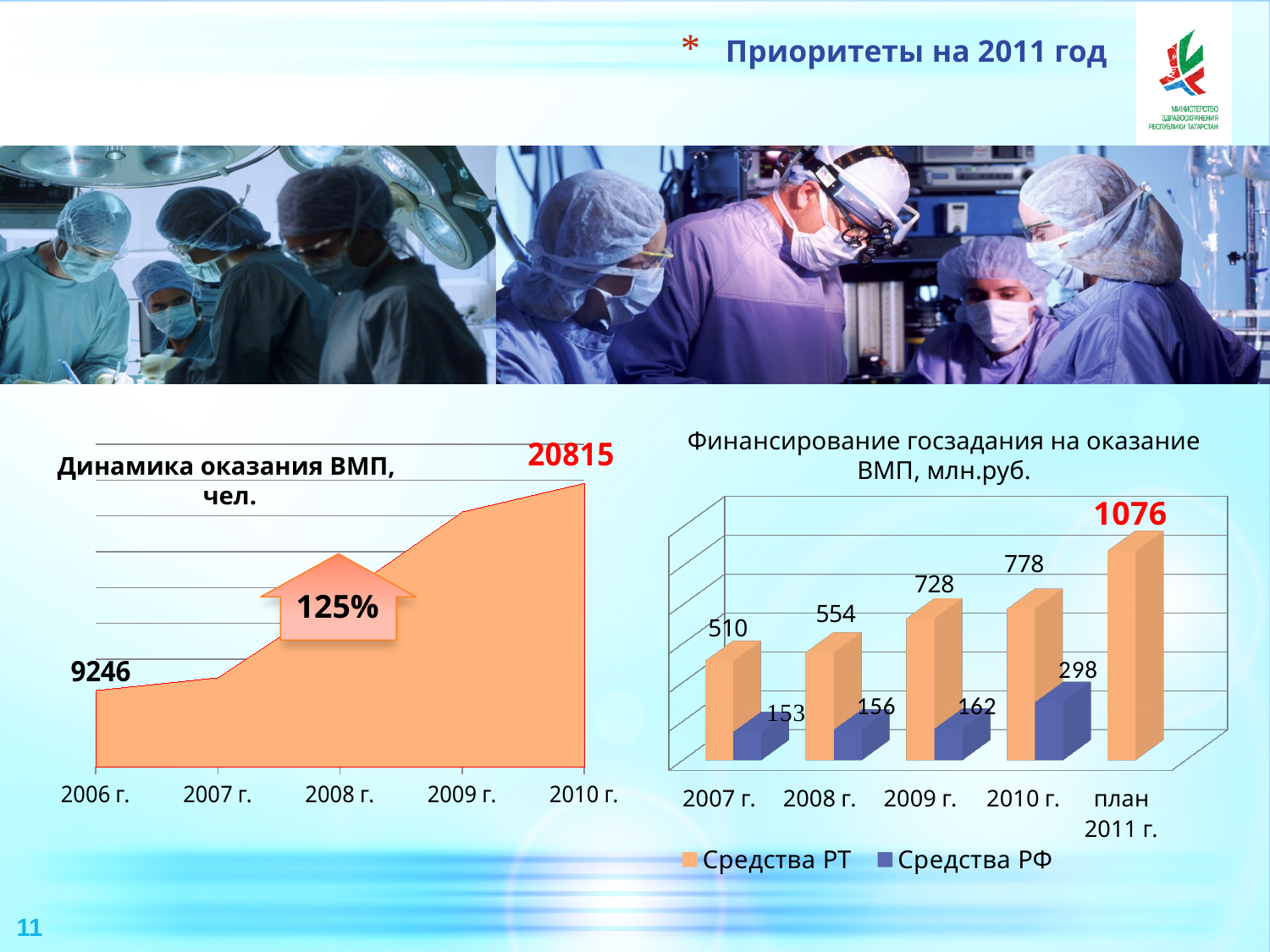
In the chart 'Финансирование госзадания на оказание ВМП, млн.руб.', what is the value of Средства РФ for 2010 г.? 298 What kind of chart is 'Финансирование госзадания на оказание ВМП, млн.руб.'? bar chart In the chart 'Динамика оказания ВМП, чел.', what is the value for 2010 г.? 20815 In the chart 'Финансирование госзадания на оказание ВМП, млн.руб.', what is the difference between Средства РТ and Средства РФ in 2009 г.? 566 In the chart 'Динамика оказания ВМП, чел.', do the values rise or fall from 2006 г. to 2010 г.? rise How many series does the legend of the chart 'Финансирование госзадания на оказание ВМП, млн.руб.' list? 2 In the chart 'Финансирование госзадания на оказание ВМП, млн.руб.', which year has the lowest value of Средства РТ? 2007 г. In the chart 'Финансирование госзадания на оказание ВМП, млн.руб.', what is the value of Средства РТ for план 2011 г.? 1076 How many years are shown on the x axis of the chart 'Динамика оказания ВМП, чел.'? 5 In the chart 'Динамика оказания ВМП, чел.', what is the difference between the 2010 г. value and the 2006 г. value? 11569 In the chart 'Динамика оказания ВМП, чел.', what is the value for 2006 г.? 9246 In the chart 'Финансирование госзадания на оказание ВМП, млн.руб.', which is larger: Средства РТ in 2008 г. or Средства РТ in 2010 г.? Средства РТ in 2010 г.